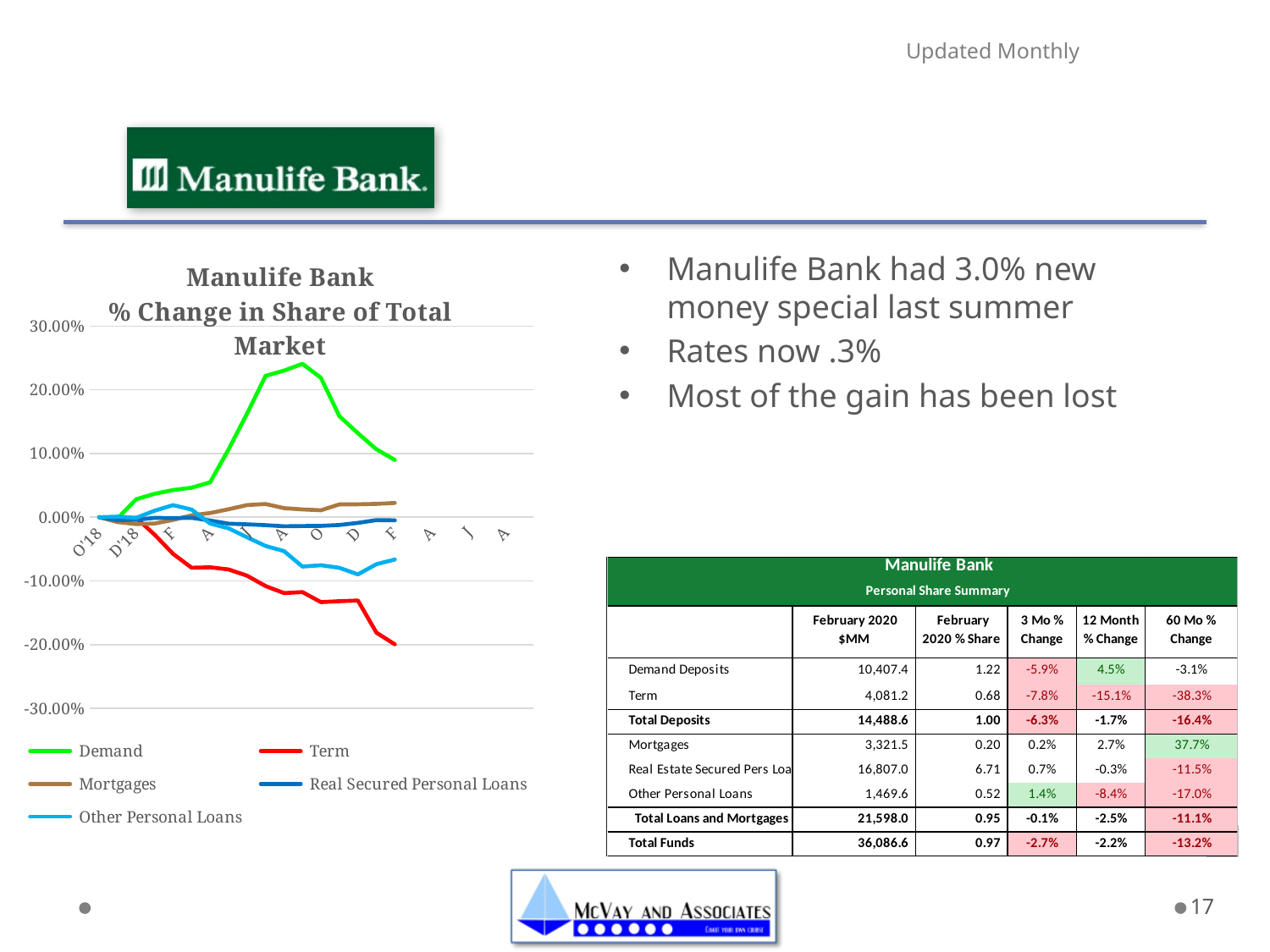
Is the final plotted value of the Term line greater or less than -10.00%? less How many labels are shown on the x axis of the chart? 12 How many series does the legend of the chart list? 5 What colour is the Demand line in the chart? green At the last plotted point, which line is higher: Demand or Term? Demand Is the peak value of the Demand line greater or less than 20.00%? greater Which series reaches the highest value on the chart? Demand What is the title of the chart? Manulife Bank % Change in Share of Total Market Is the lowest value of the Term line greater or less than -10.00%? less Which series reaches the lowest value on the chart? Term Does the Term line rise or fall overall from O'18 to its last plotted point? fall What kind of chart is shown on the slide? line chart